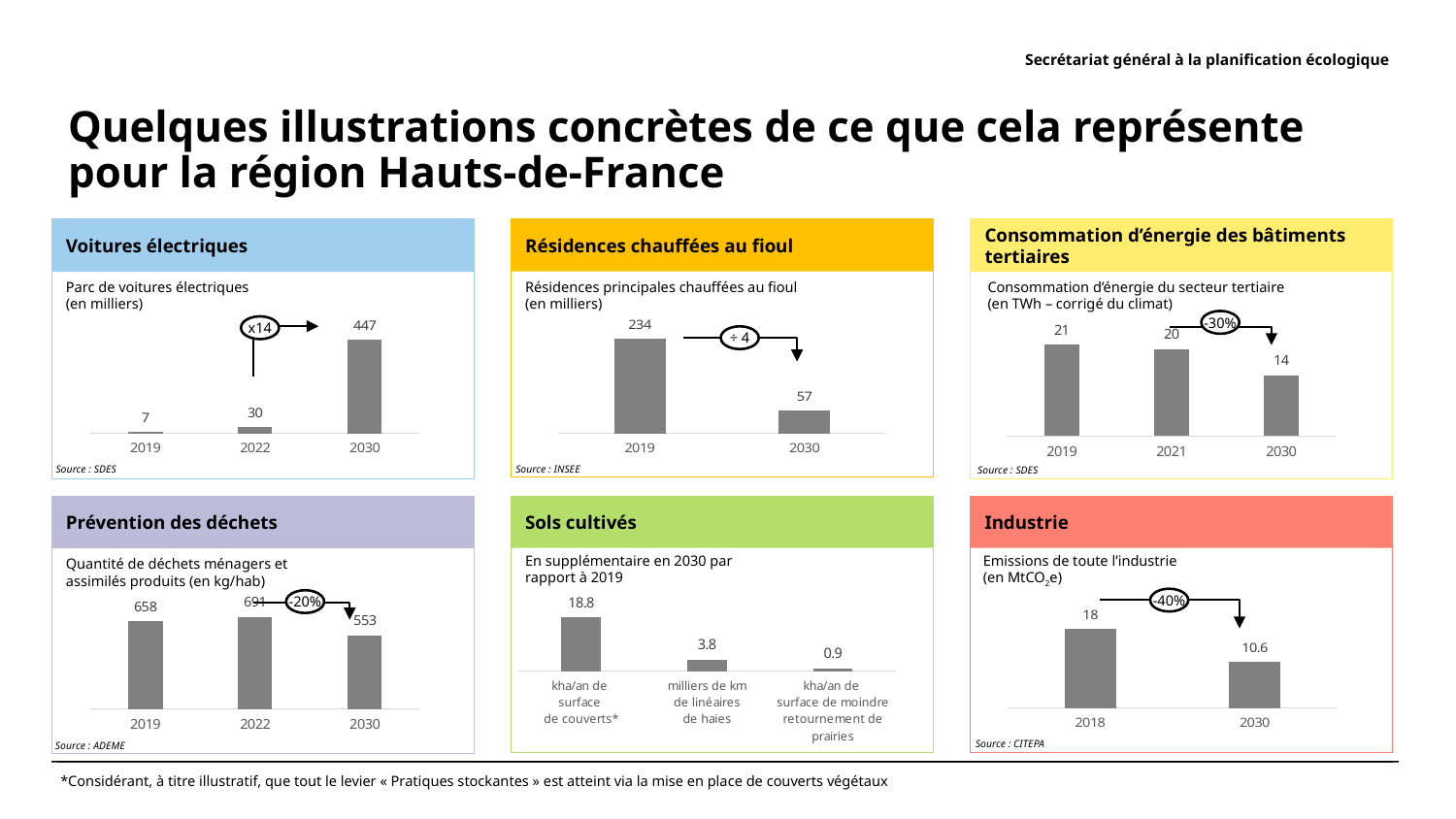
In the 'Prévention des déchets' chart, what is the value for 2030? 553 In the 'Résidences chauffées au fioul' chart, what is the value for 2019? 234 In the 'Sols cultivés' chart, what is the value for 'milliers de km de linéaires de haies'? 3.8 In the 'Sols cultivés' chart, how many categories are shown? 3 In the 'Prévention des déchets' chart, which year has the highest value? 2022 What kind of chart is used in the 'Industrie' panel? bar chart In the 'Industrie' chart, which is larger, the value for 2018 or for 2030? 2018 In the 'Voitures électriques' chart, what is the difference between the 2030 and 2022 values? 417 In the 'Voitures électriques' chart, what is the value for 2030? 447 In the 'Consommation d'énergie des bâtiments tertiaires' chart, do the values rise or fall from 2019 to 2030? fall In the 'Consommation d'énergie des bâtiments tertiaires' chart, which year has the lowest value? 2030 In the 'Résidences chauffées au fioul' chart, how many bars are plotted? 2